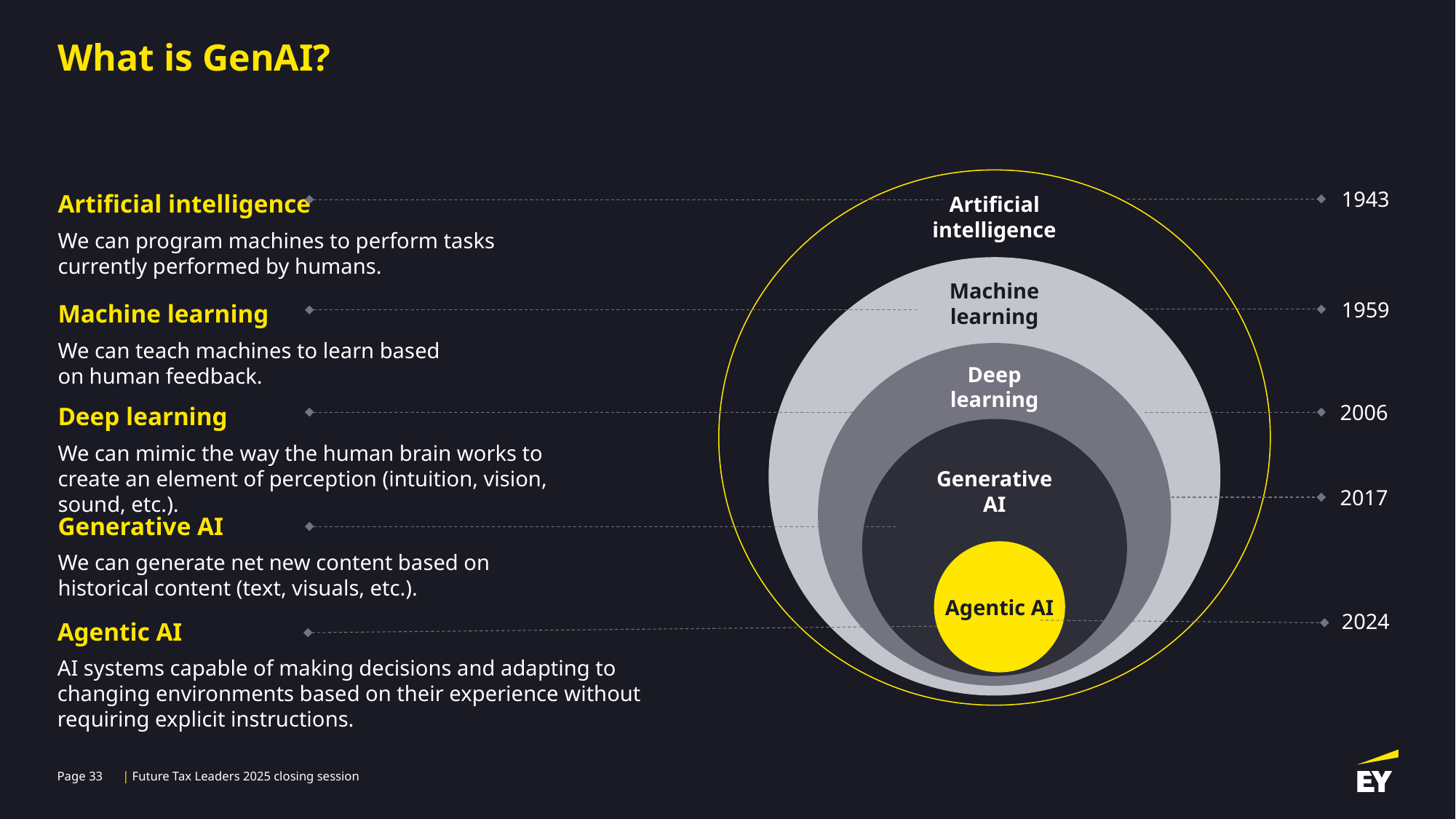
In the nested circle diagram, what year is shown next to Deep learning? 2006 In the nested circle diagram, what year is shown next to Agentic AI? 2024 How many years separate Machine learning (1959) and Deep learning (2006) in the diagram? 47 How many nested circles (levels) are shown in the diagram? 5 How many years separate Generative AI (2017) and Agentic AI (2024) in the diagram? 7 Do the years in the diagram increase or decrease as you move from the outermost circle to the innermost circle? increase Which level in the diagram has the latest year? Agentic AI Which level in the diagram has the earliest year? Artificial intelligence In the nested circle diagram, what year is shown next to Artificial intelligence? 1943 In the nested circle diagram, what year is shown next to Machine learning? 1959 What colour is the innermost Agentic AI circle in the diagram? yellow In the nested circle diagram, what year is shown next to Generative AI? 2017